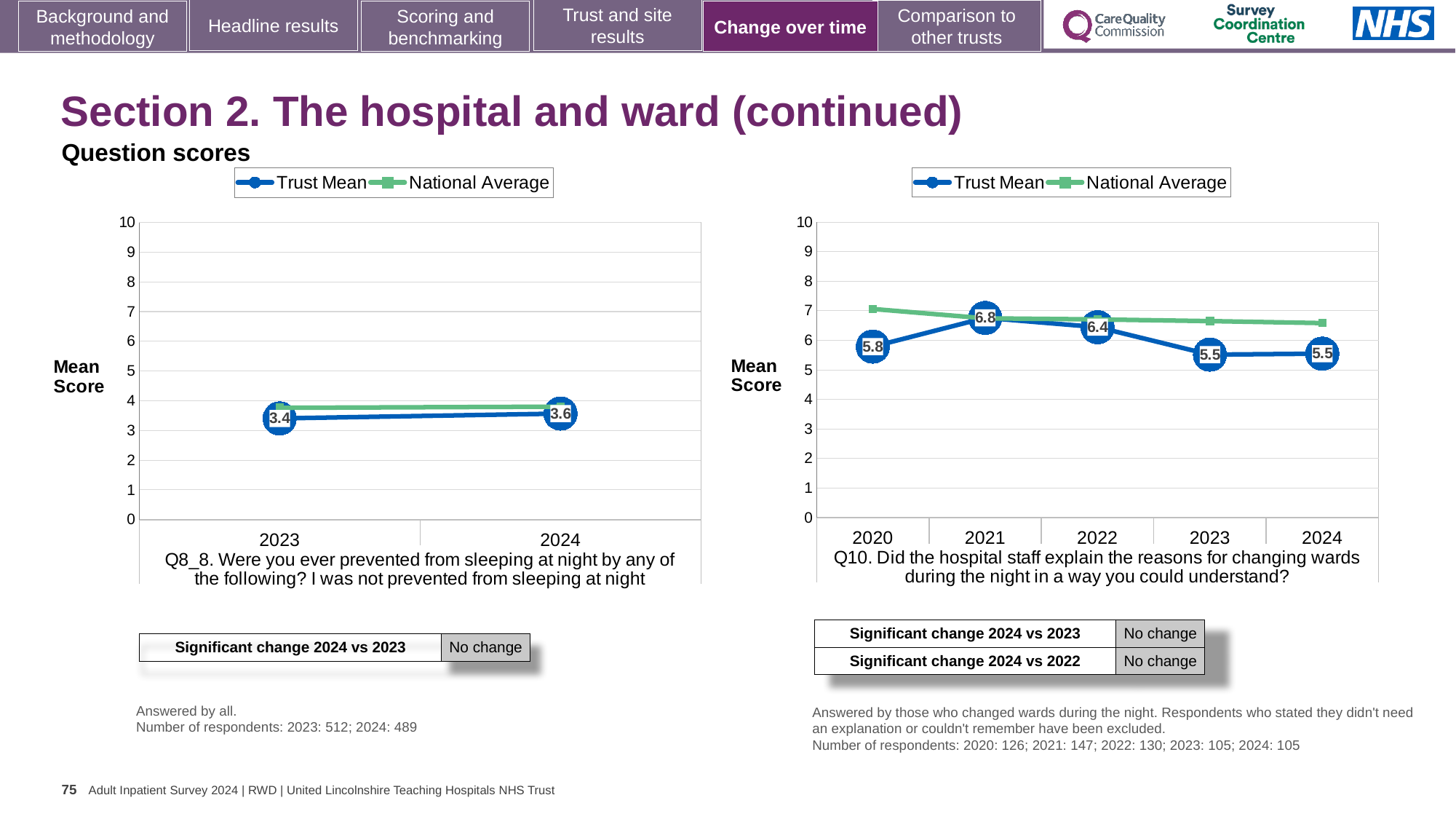
In the Q10 chart on the right, what is the Trust Mean score for 2021? 6.8 In the Q10 chart on the right, is the National Average for 2020 greater or less than 6? greater In the Q10 chart on the right, is the Trust Mean for 2020 larger or smaller than the Trust Mean for 2022? smaller What type of chart is used for the Q10 chart on the right? Line chart In the Q10 chart on the right, what is the Trust Mean score for 2020? 5.8 How many years are plotted on the x axis of the Q10 chart on the right? 5 In the Q8_8 chart on the left, what is the Trust Mean score for 2024? 3.6 In the Q8_8 chart on the left, by how much did the Trust Mean change from 2023 to 2024? 0.2 In the Q8_8 chart on the left, what is the Trust Mean score for 2023? 3.4 In the Q10 chart on the right, what is the difference between the Trust Mean in 2021 and in 2022? 0.4 How many series does the legend of the Q8_8 chart on the left list? 2 In the Q10 chart on the right, which year has the highest Trust Mean score? 2021